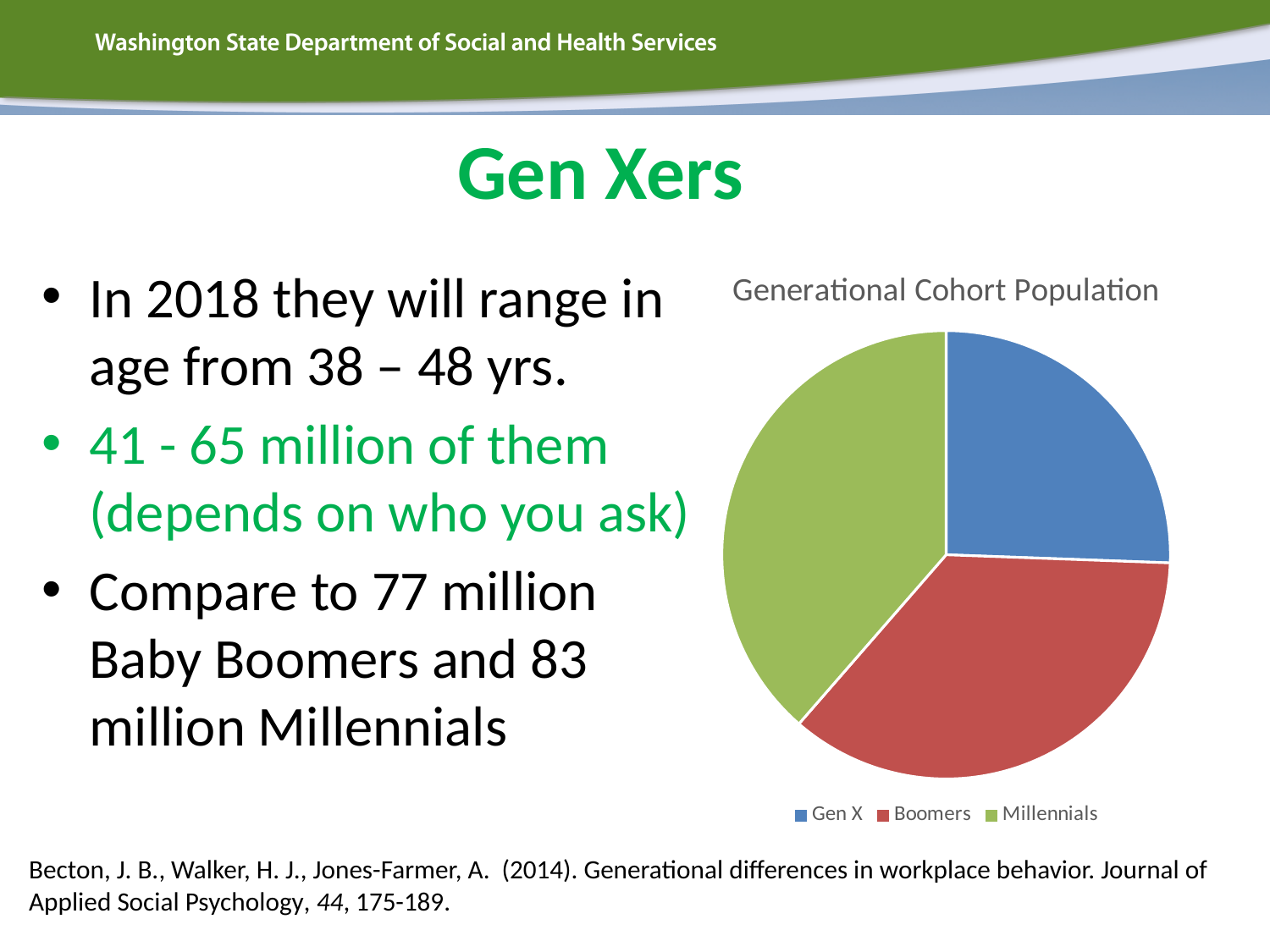
What is the title of the chart? Generational Cohort Population Which colour represents Boomers in the pie chart? red Which cohort is shown in green in the pie chart? Millennials Which generational cohort has the smallest slice in the pie chart? Gen X Which slice is larger in the pie chart, Gen X or Millennials? Millennials Which slice is larger in the pie chart, Gen X or Boomers? Boomers How many slices does the pie chart have? 3 What kind of chart is shown on the slide? pie chart How many entries does the chart legend list? 3